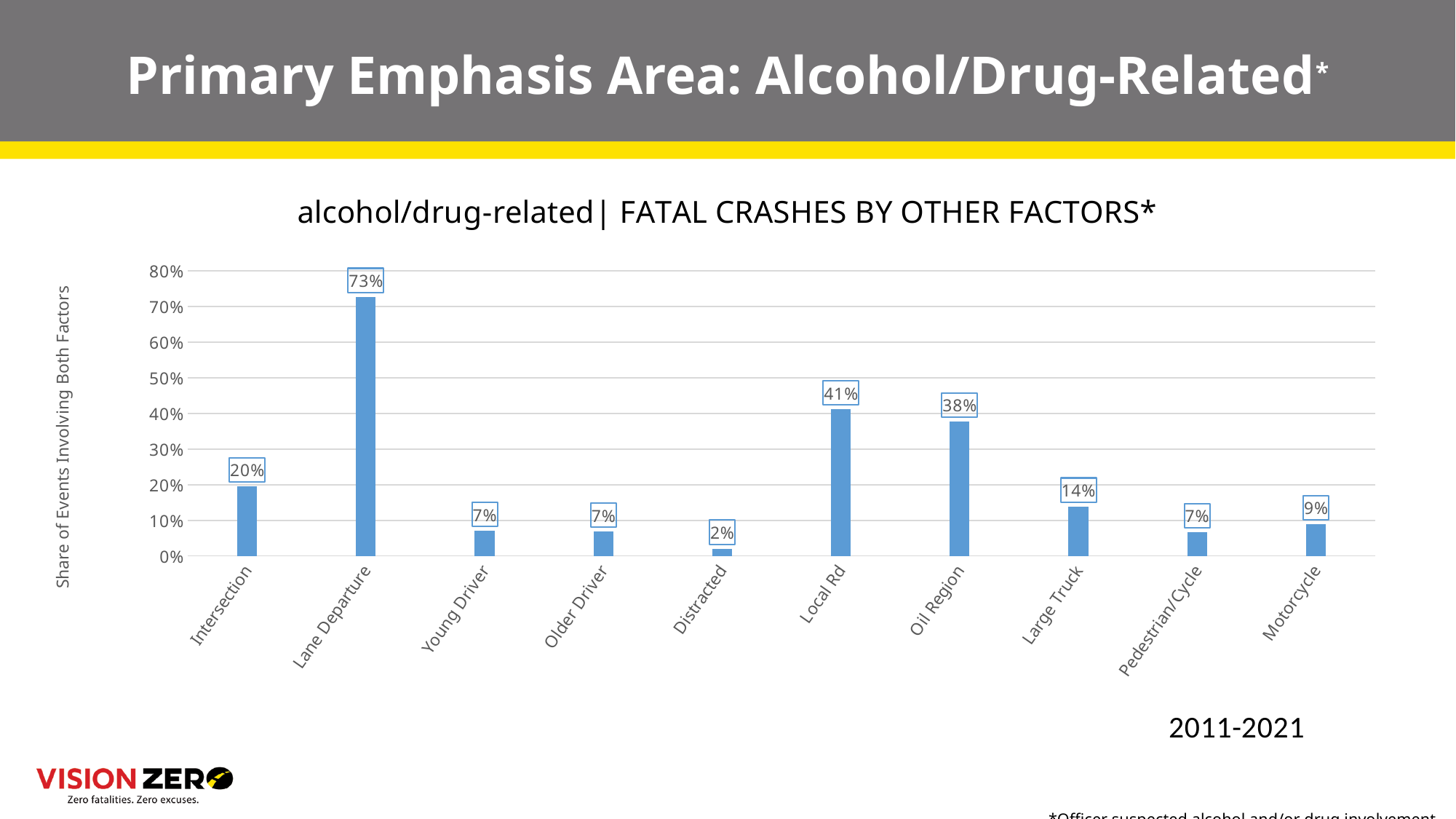
What is the value for Local Rd? 41% Which is larger, the value for Intersection or the value for Large Truck? Intersection What is the difference between the values for Lane Departure and Local Rd? 32% What is the value for Large Truck? 14% Which category has the highest value? Lane Departure What is the y-axis label of the chart? Share of Events Involving Both Factors What is the value for Oil Region? 38% What is the value for Lane Departure? 73% What kind of chart is shown on the slide? bar chart Which category has the lowest value? Distracted Is the value for Oil Region greater or less than 30%? greater How many categories are shown on the x axis? 10